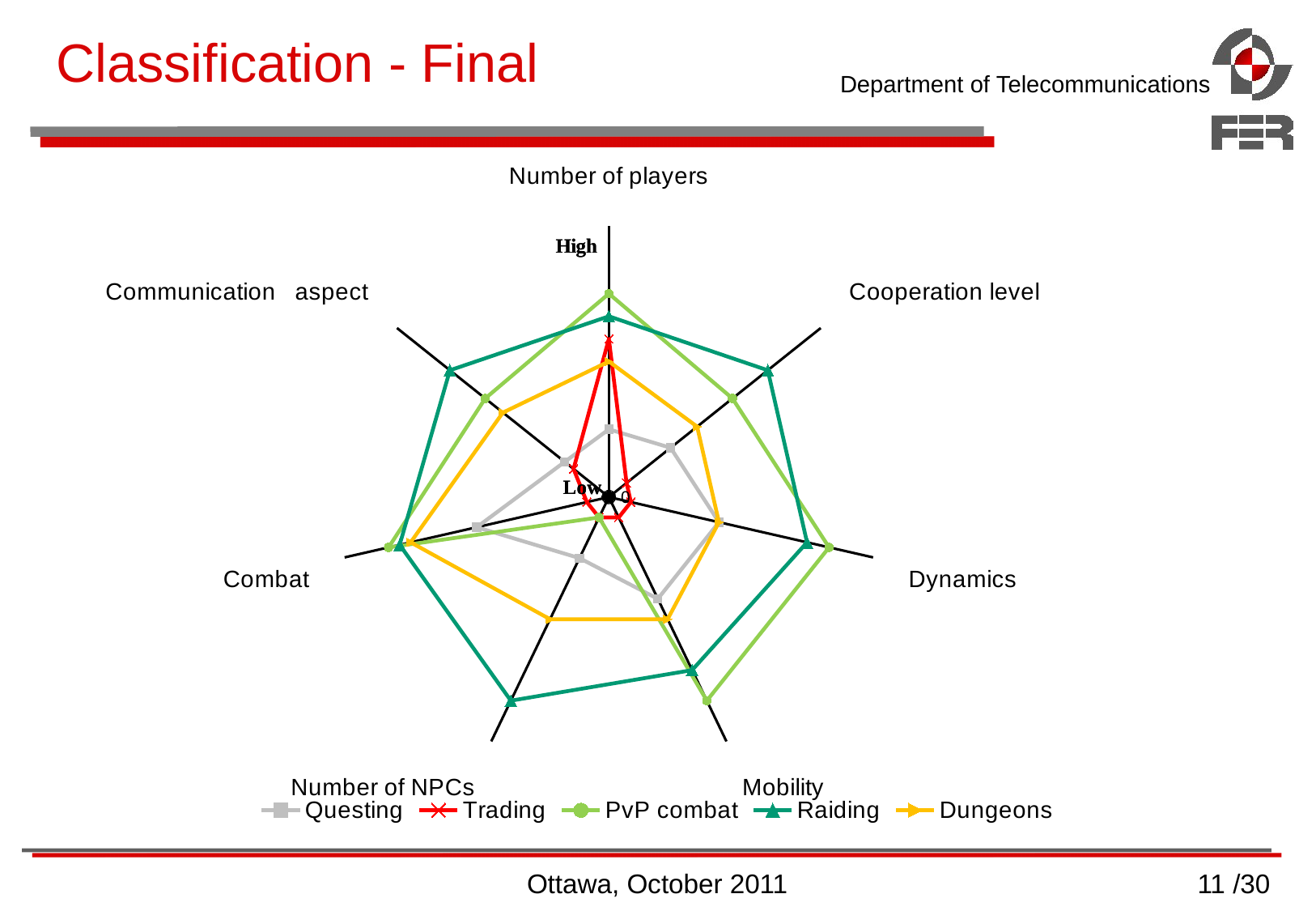
Which series has the lowest value on the Mobility axis? Trading How many axes (categories) does the radar chart have? 7 What kind of chart is shown on the slide? Radar chart Which series has the highest value on the Cooperation level axis? Raiding How many series does the legend list? 5 On the Number of players axis, which is higher: Trading or Questing? Trading On the Combat axis, which is higher: Raiding or Questing? Raiding What are the two labels printed on the vertical axis scale of the radar chart? High and Low Which series is drawn in red? Trading Which series has the highest value on the Number of players axis? PvP combat Which series has the highest value on the Communication aspect axis? Raiding